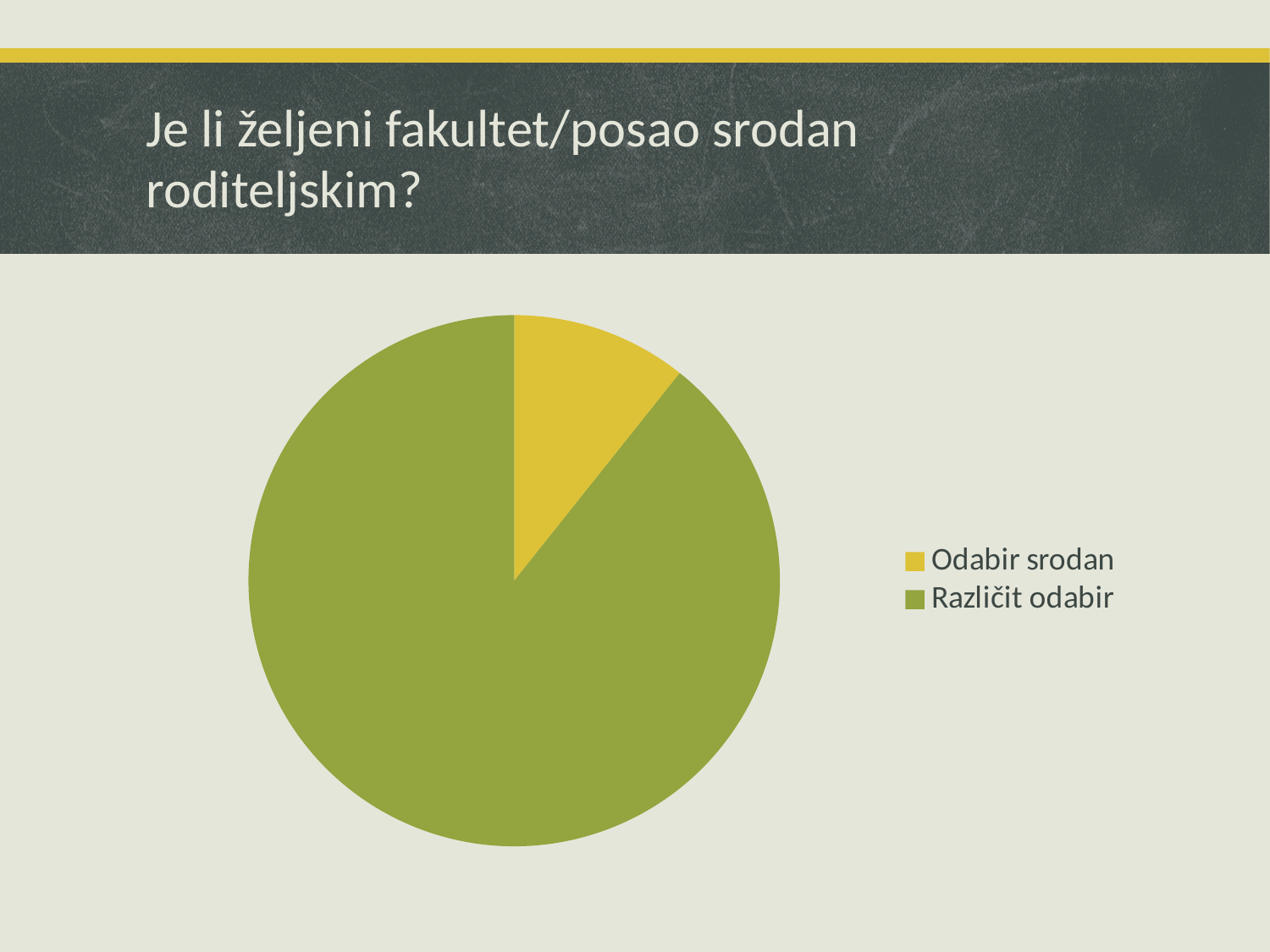
What is the title of the slide containing the pie chart? Je li željeni fakultet/posao srodan roditeljskim? Which category has the largest slice of the pie chart? Različit odabir How many slices does the pie chart have? 2 What kind of chart is shown on the slide? pie chart How many entries does the legend of the pie chart list? 2 Which slice is larger, "Odabir srodan" or "Različit odabir"? Različit odabir What colour is the "Odabir srodan" slice in the pie chart? yellow Which category has the smallest slice of the pie chart? Odabir srodan